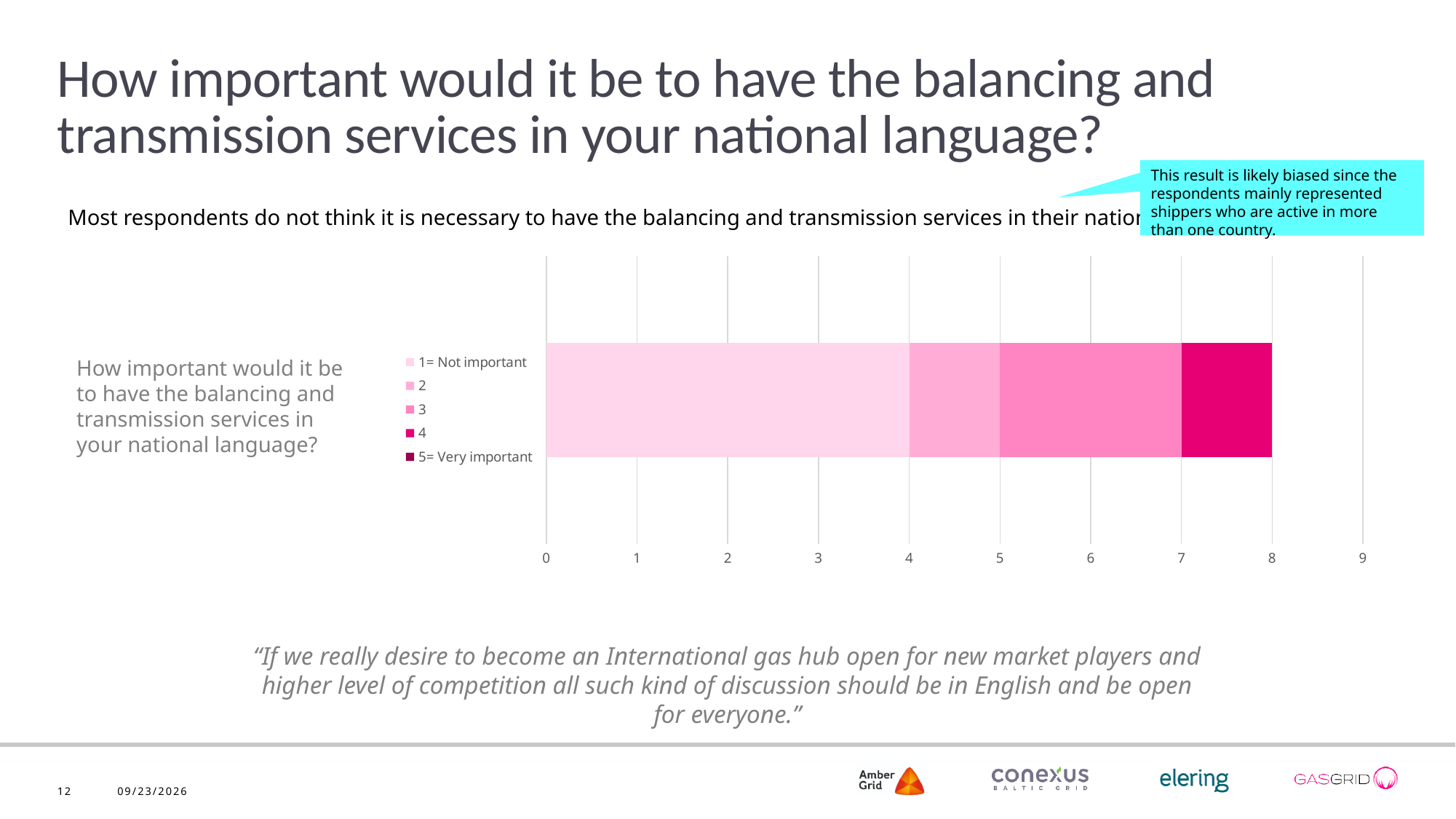
What is the total length of the stacked bar, as read from the x axis? 8 What value does the '1= Not important' segment reach on the x axis? 4 Which series has the largest segment in the stacked bar? 1= Not important Is the value for '1= Not important' greater or less than 3? greater Which segment is larger, '1= Not important' or '3'? 1= Not important Is the total length of the stacked bar greater or less than 9? less Which segment is larger, '2' or '3'? 3 What kind of chart is shown on the slide? Stacked bar chart How many series does the chart legend list? 5 How many categories (bars) are plotted in the chart? 1 What is the highest value shown on the x axis of the chart? 9 What is the label of the last entry in the chart legend? 5= Very important